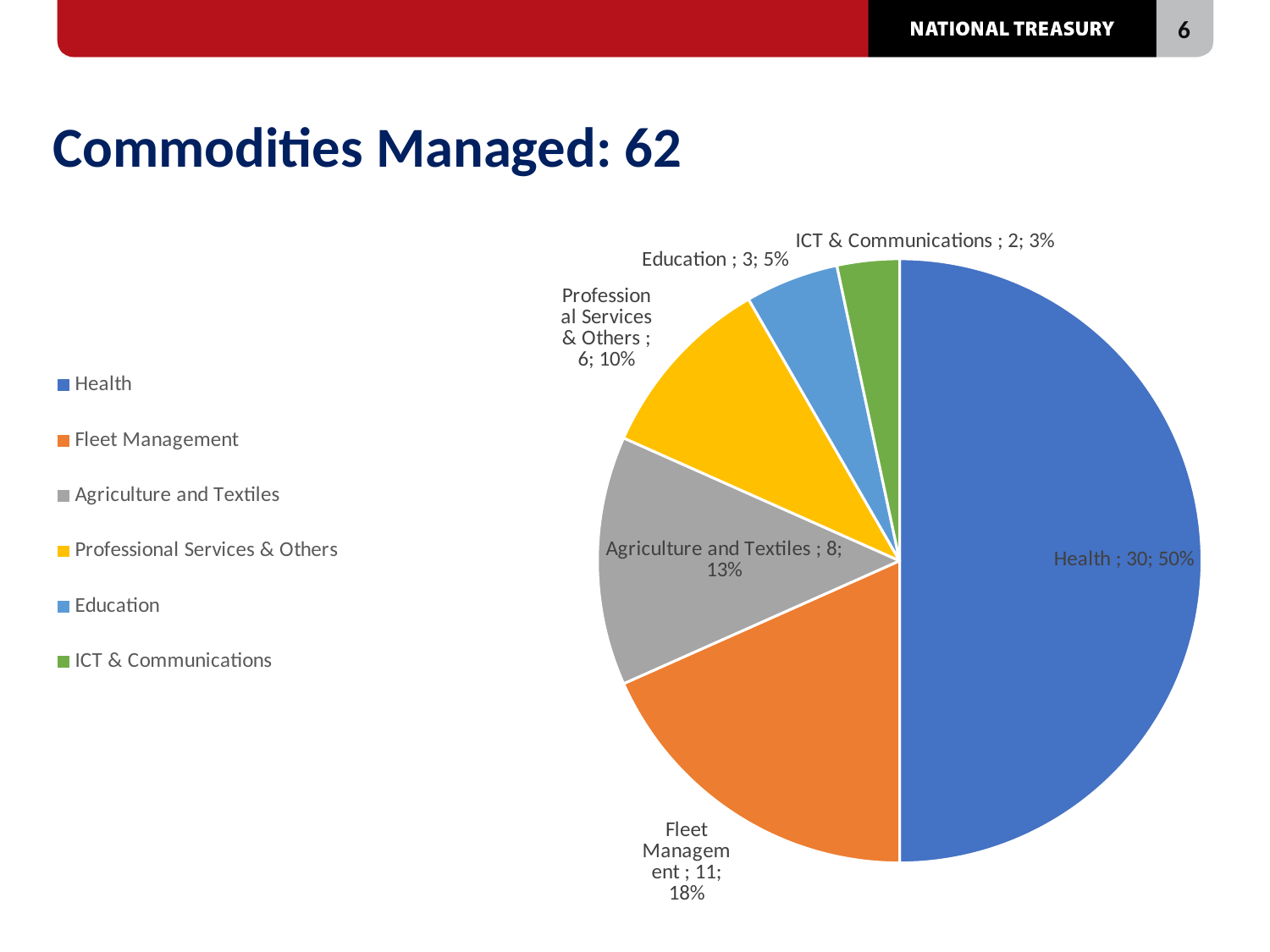
What kind of chart is shown on the slide? pie chart Which category has the smallest slice? ICT & Communications How many commodities are in the Health category? 30 What percentage share does Professional Services & Others have? 10% What percentage share does Fleet Management have? 18% Which category has the largest slice? Health What is the difference between the Health count and the Fleet Management count? 19 How many categories does the pie chart show? 6 What is the total of all the slice counts in the pie chart? 60 What colour is the Agriculture and Textiles slice? grey Which is larger, Education or ICT & Communications? Education How many commodities are in the Agriculture and Textiles category? 8